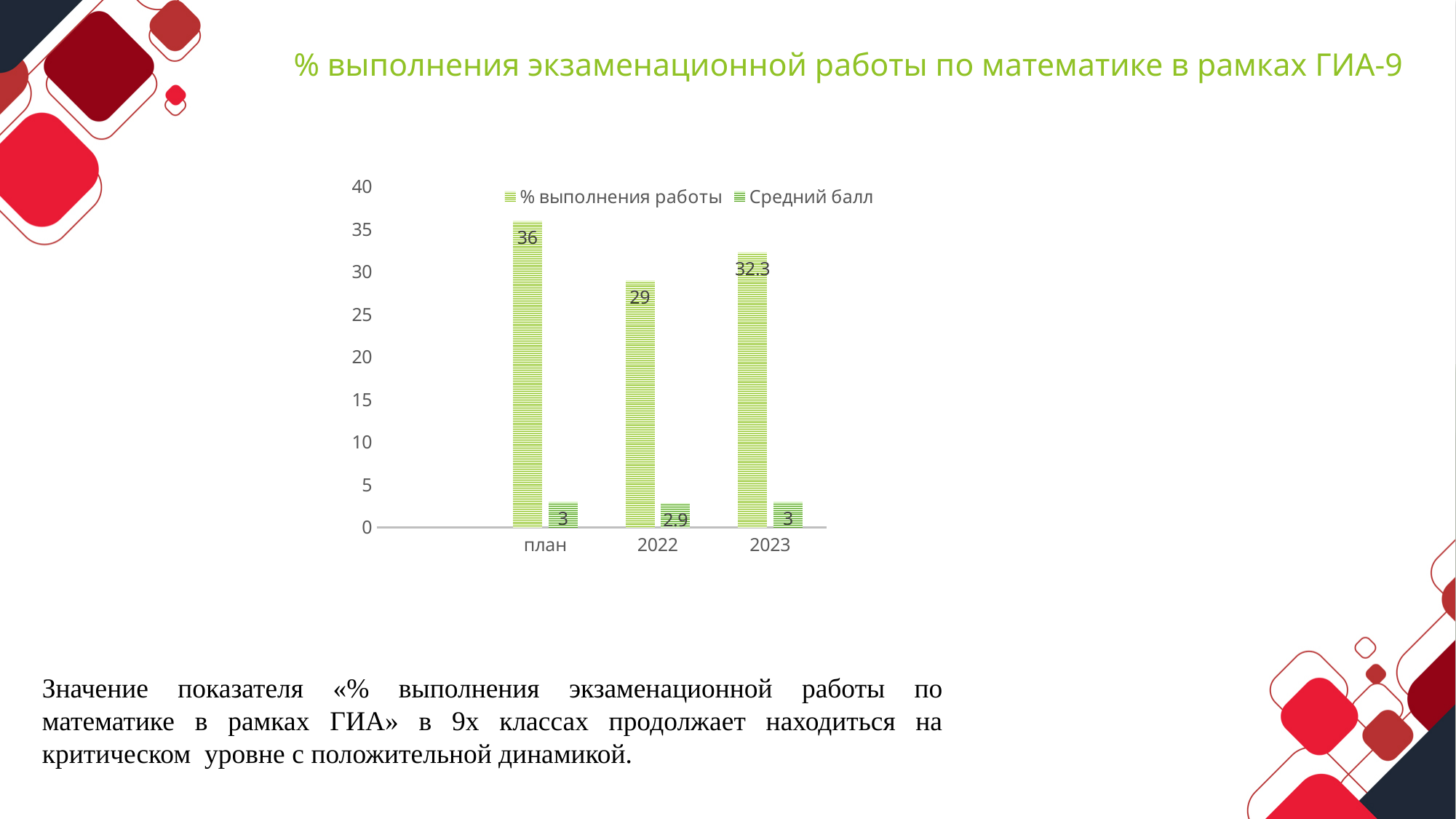
How many series does the legend list? 2 What is the value of "Средний балл" for 2023? 3 Which category has the lowest value for "% выполнения работы"? 2022 What is the difference between the "% выполнения работы" values for план and 2022? 7 What is the value of "% выполнения работы" for 2022? 29 What is the value of "% выполнения работы" for план? 36 How many categories are shown on the x axis? 3 Which category has the highest value for "% выполнения работы"? план What is the value of "Средний балл" for 2022? 2.9 Which is larger, the "% выполнения работы" value for 2023 or for 2022? 2023 What is the value of "% выполнения работы" for 2023? 32.3 What kind of chart is shown on the slide? bar chart